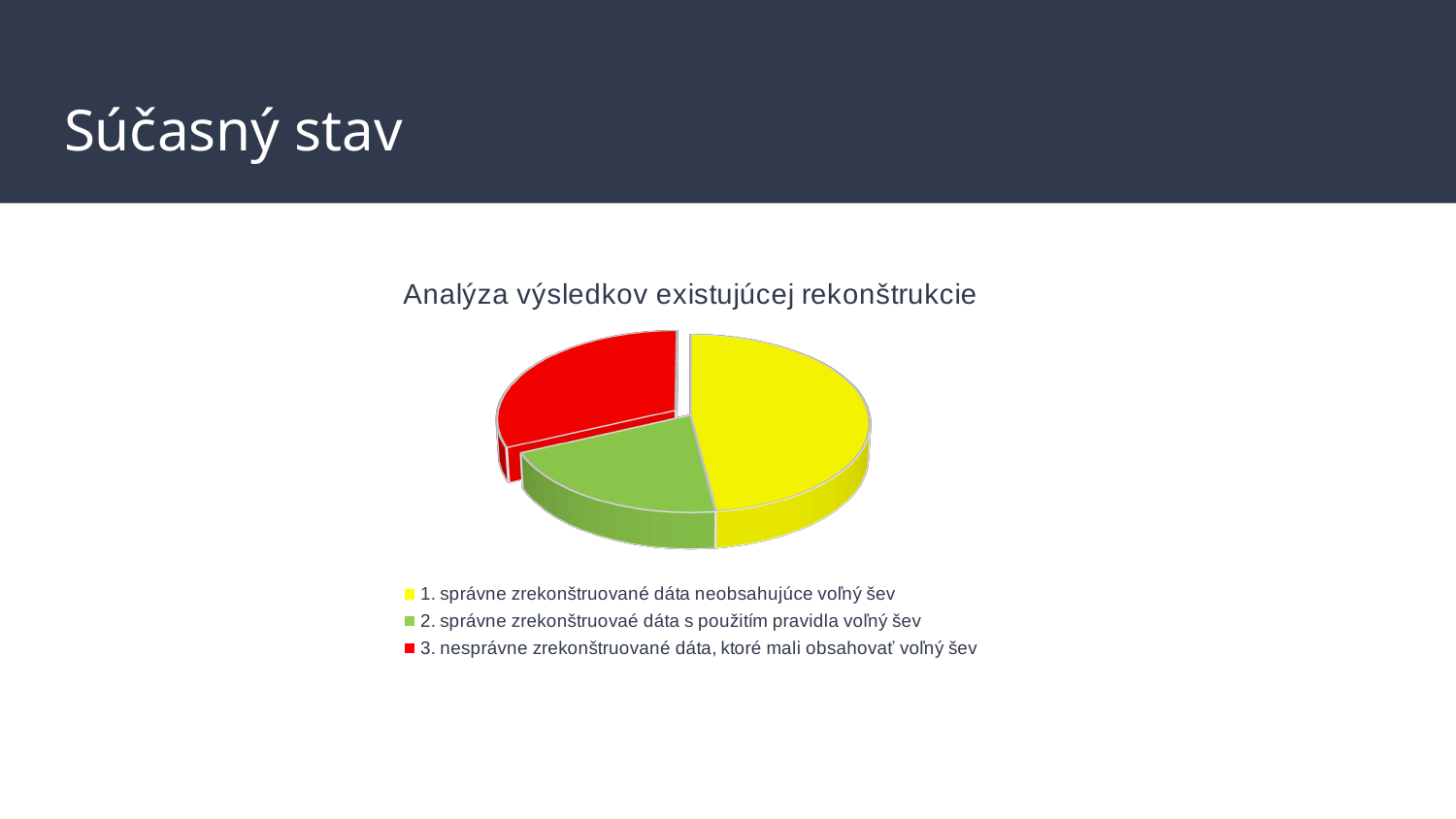
What is the title of the chart? Analýza výsledkov existujúcej rekonštrukcie How many slices does the pie chart have? 3 What colour is the slice for '3. nesprávne zrekonštruované dáta, ktoré mali obsahovať voľný šev'? red Which slice is larger: '1. správne zrekonštruované dáta neobsahujúce voľný šev' or '3. nesprávne zrekonštruované dáta, ktoré mali obsahovať voľný šev'? 1. správne zrekonštruované dáta neobsahujúce voľný šev Which category has the largest slice of the pie? 1. správne zrekonštruované dáta neobsahujúce voľný šev What kind of chart is shown on the slide? pie chart How many entries does the chart legend list? 3 Which slice is larger: '1. správne zrekonštruované dáta neobsahujúce voľný šev' or '2. správne zrekonštruovaé dáta s použitím pravidla voľný šev'? 1. správne zrekonštruované dáta neobsahujúce voľný šev